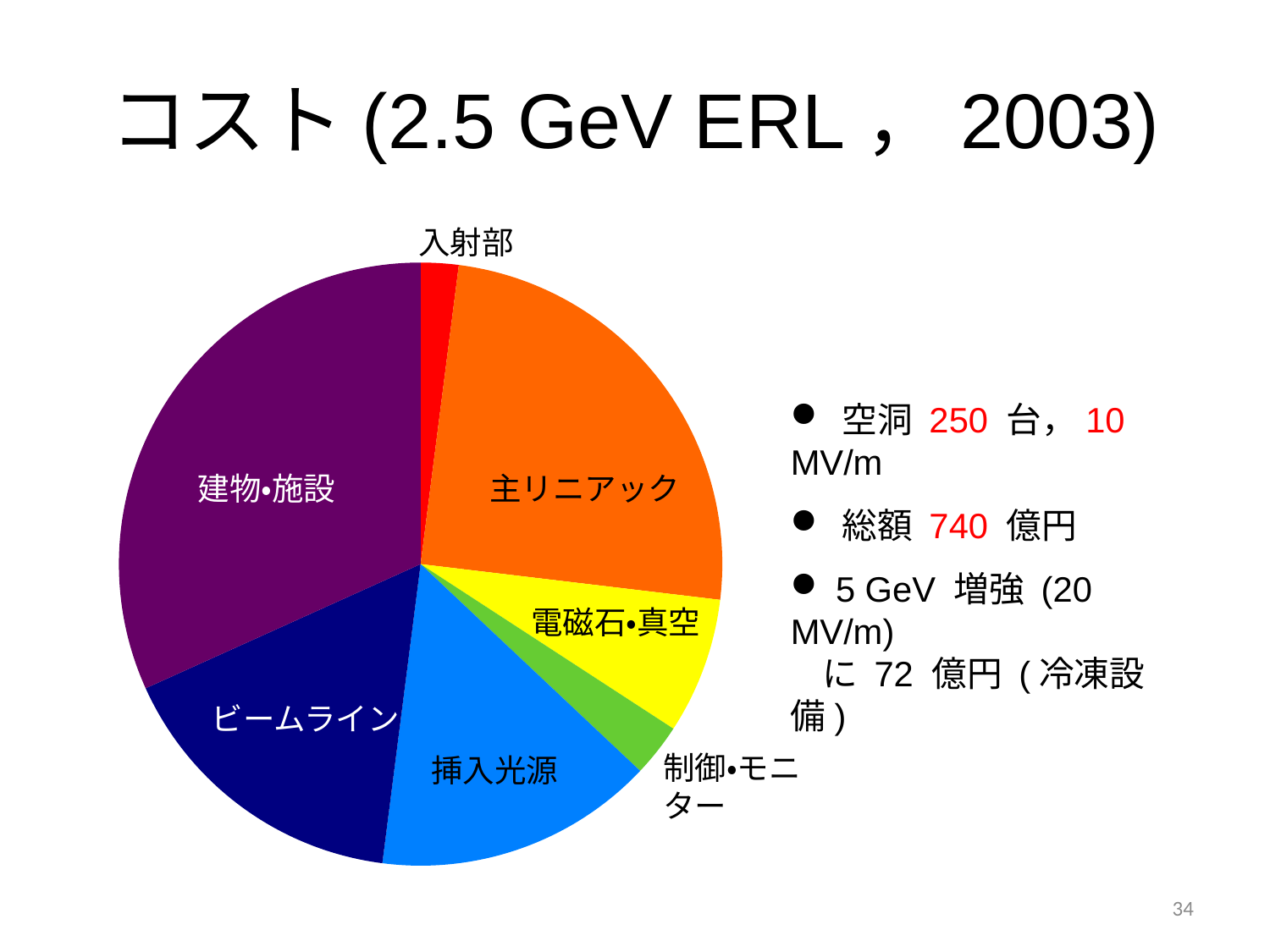
Which slice is larger, 挿入光源 or 制御•モニター? 挿入光源 What is the title of the slide containing the pie chart? コスト (2.5 GeV ERL , 2003) Which slice is larger, 主リニアック or 電磁石•真空? 主リニアック What kind of chart is shown on the slide? pie chart How many slices does the pie chart have? 7 What colour is the 主リニアック slice of the pie chart? orange Which slice is larger, ビームライン or 入射部? ビームライン Which category has the largest slice of the pie chart? 建物•施設